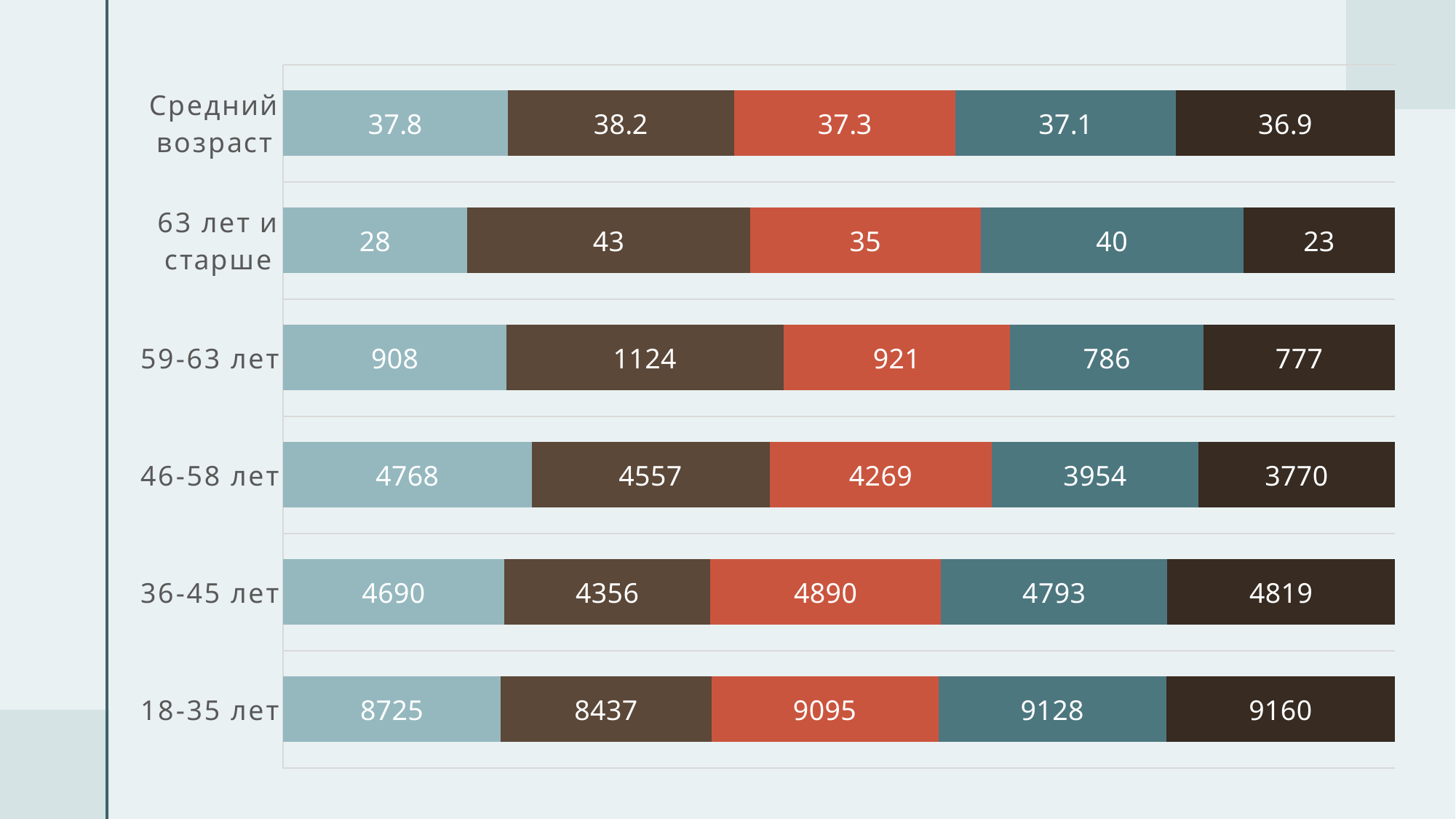
In the bar for 18-35 лет, which is larger: the red segment or the leftmost light blue segment? The red segment (9095) What is the value of the rightmost (dark brown) segment for the category Средний возраст? 36.9 Which segment has the largest value in the bar for 63 лет и старше? 43 What is the total of all segments in the bar for 63 лет и старше? 169 How many categories are listed on the vertical axis of the chart? 6 What is the value of the leftmost (light blue) segment for the category 18-35 лет? 8725 How many segments does each bar in the chart contain? 5 What is the value of the red segment for the category 36-45 лет? 4890 Which segment has the smallest value in the bar for 46-58 лет? 3770 What is the value of the second (brown) segment for the category 59-63 лет? 1124 What kind of chart is shown on the slide? Stacked bar chart What is the difference between the second segment (1124) and the first segment (908) in the bar for 59-63 лет? 216